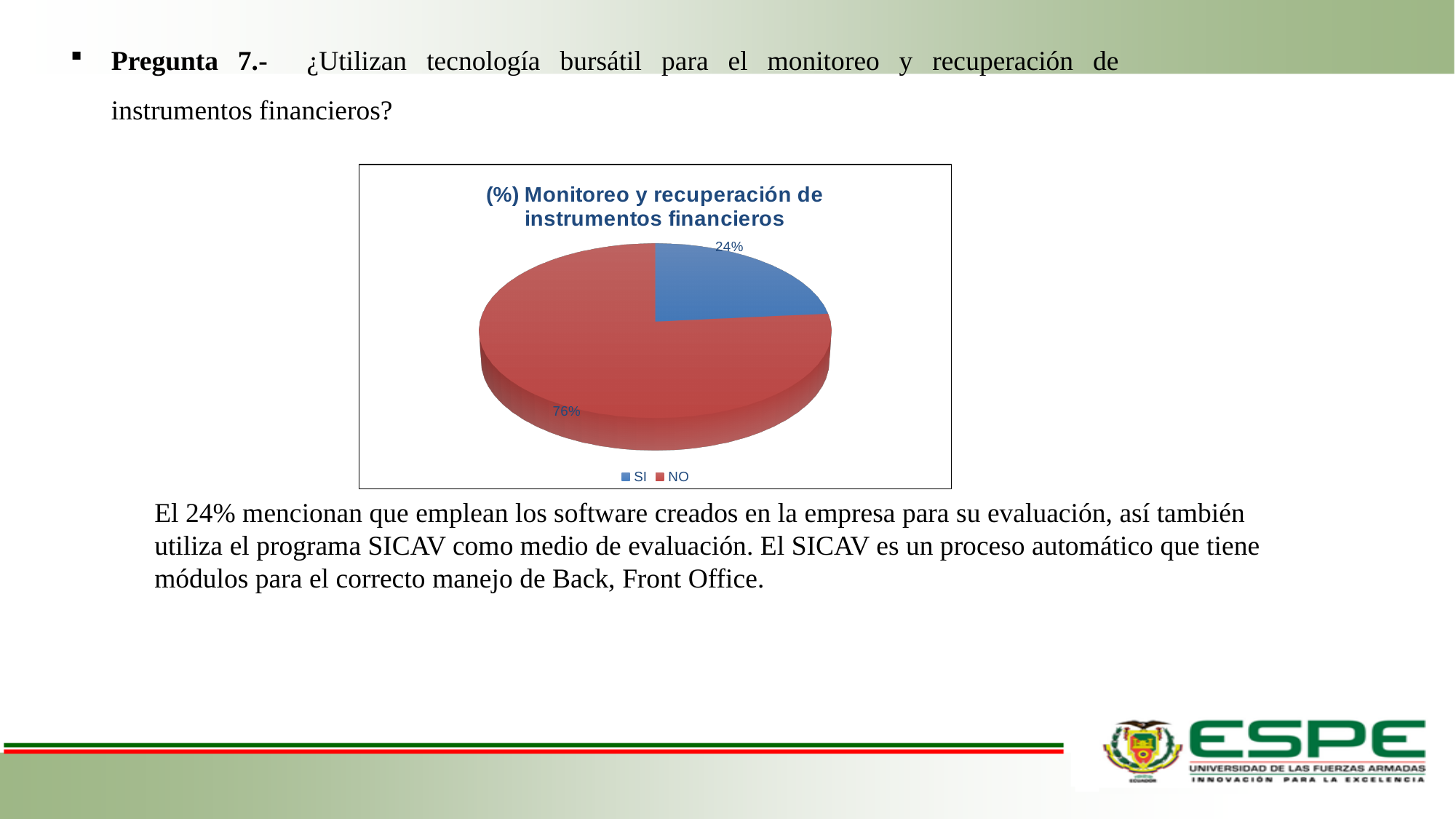
Which is larger, the share for SI or the share for NO? NO What percentage of the pie corresponds to NO? 76% What kind of chart is shown on the slide? Pie chart Which category has the largest share of the pie? NO How many categories does the pie chart have? 2 What colour is the slice for NO? Red How many entries does the legend list? 2 What is the title of the chart? (%) Monitoreo y recuperación de instrumentos financieros What is the difference in percentage points between NO and SI? 52 Which category has the smallest share of the pie? SI What is the share of the pie for SI? 24% What percentage of the pie corresponds to SI? 24%